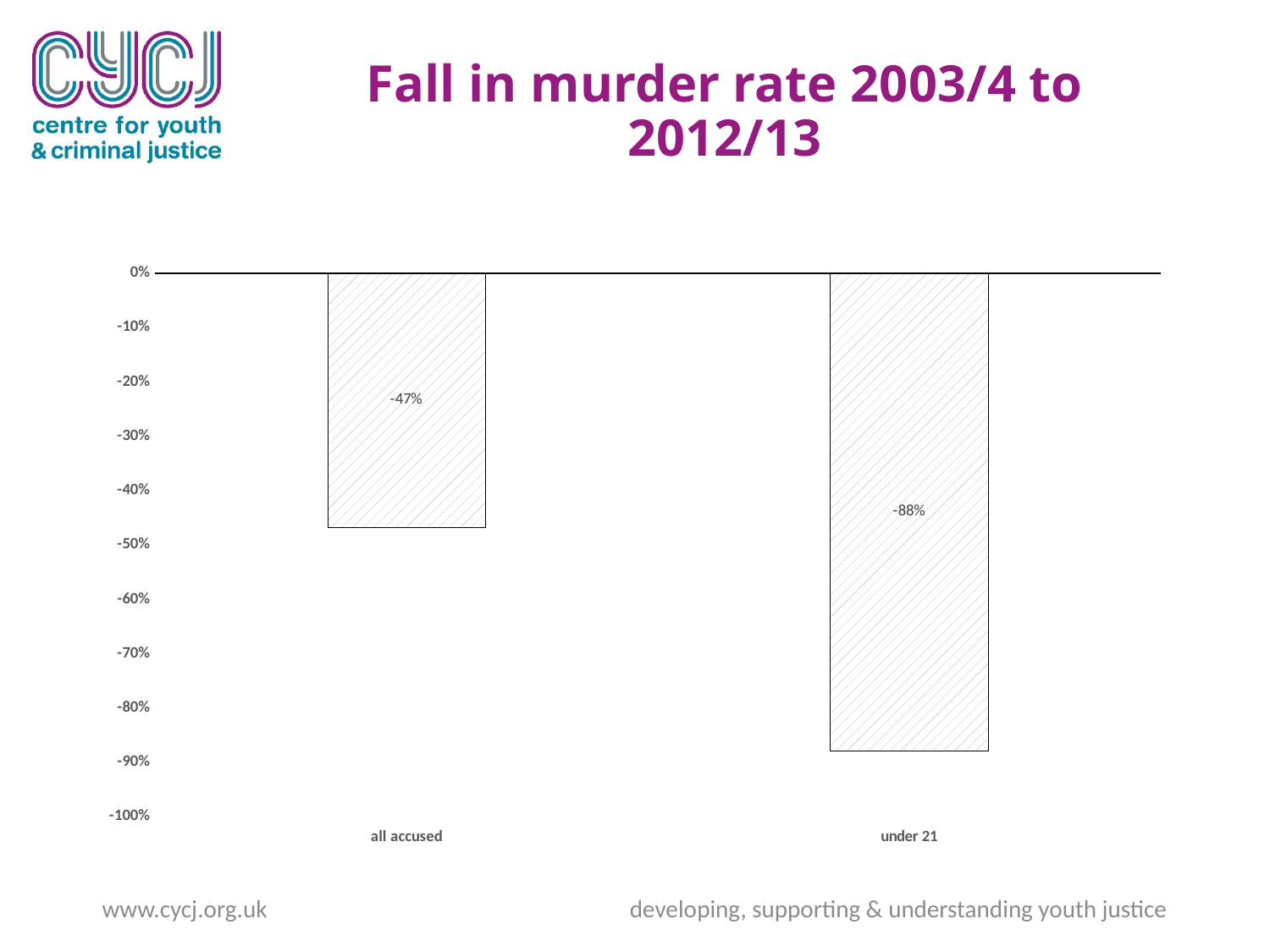
Which category shows the smaller fall in murder rate? all accused Is the value for "all accused" greater or less than -50%? greater What is the value for "under 21"? -88% What is the title of the slide? Fall in murder rate 2003/4 to 2012/13 How many categories are shown on the x axis? 2 Is the fall for "under 21" greater or less than the fall for "all accused"? greater What is the lowest value shown on the y axis? -100% What is the difference in percentage points between the fall for "under 21" and the fall for "all accused"? 41 percentage points What kind of chart is shown on the slide? bar chart Which category shows the larger fall in murder rate? under 21 Is the value for "under 21" greater or less than -80%? less What is the value for "all accused"? -47%